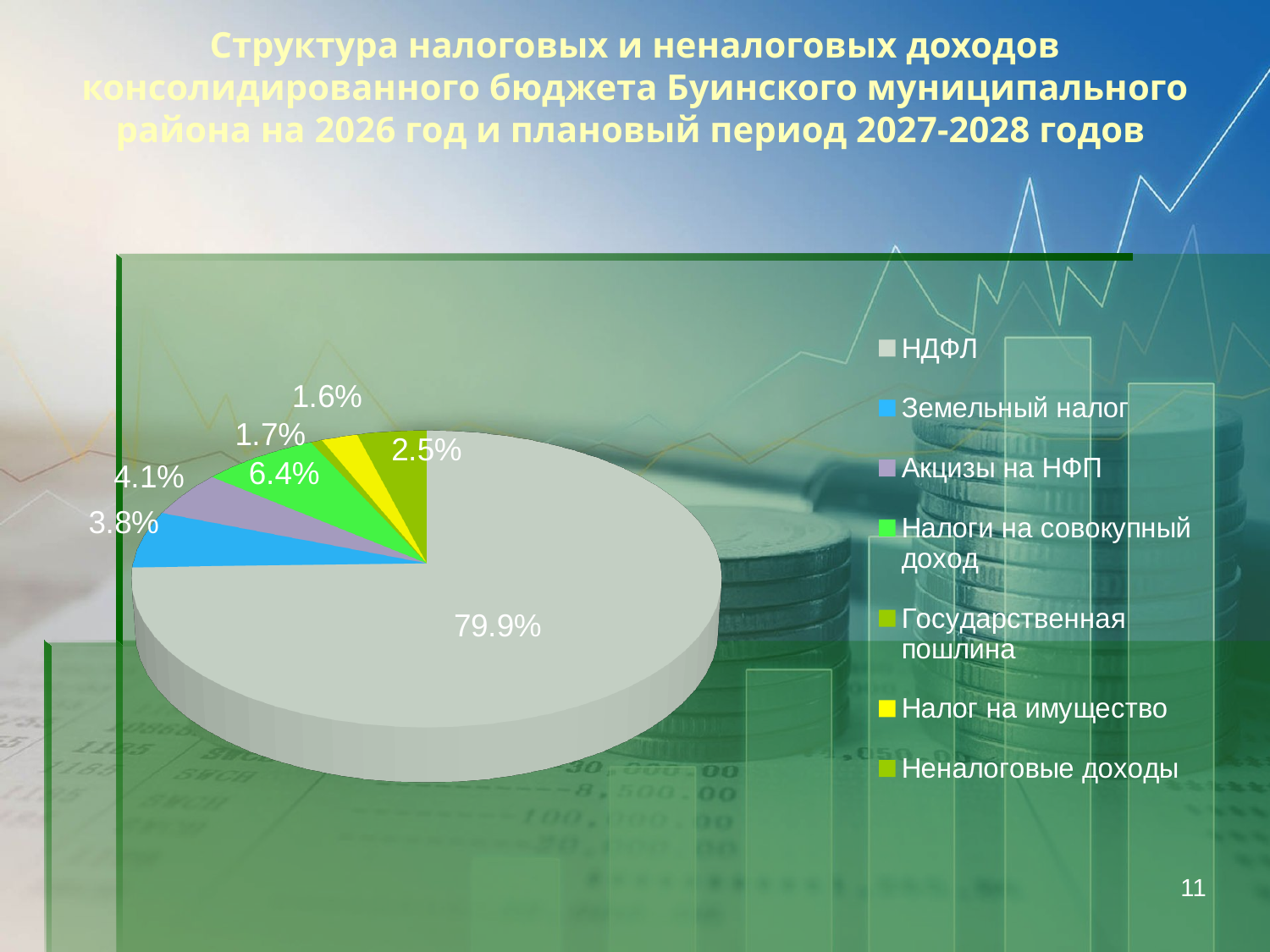
What share of the pie does НДФЛ account for? 79.9% What percentage is shown for Неналоговые доходы? 2.5% What is the smallest percentage label shown on the pie chart? 1.6% Which is larger: the share of Налоги на совокупный доход or the share of Неналоговые доходы? Налоги на совокупный доход What percentage is shown for Земельный налог? 3.8% What kind of chart is shown on the slide? pie chart By how many percentage points does НДФЛ exceed Налоги на совокупный доход? 73.5% Which category has the largest share of the pie? НДФЛ What colour is the НДФЛ slice in the pie chart? grey What percentage is shown for Налоги на совокупный доход? 6.4% What percentage is shown for Акцизы на НФП? 4.1% How many categories does the legend of the pie chart list? 7